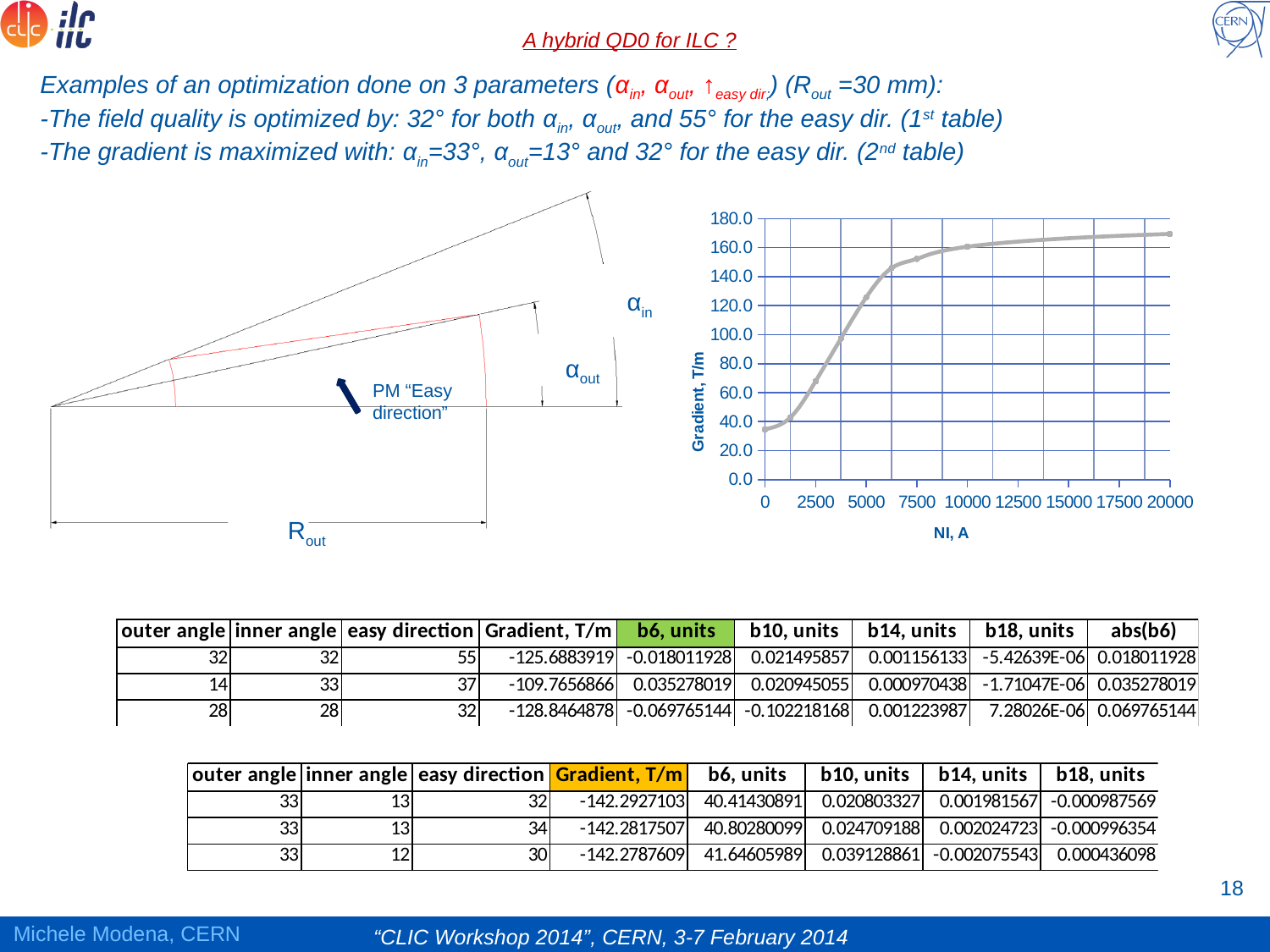
Is the gradient at NI = 0 A greater or less than 40 T/m? less What is the label of the x axis of the chart? NI, A Is the gradient at NI = 20000 A greater or less than 160 T/m? greater At which NI value is the gradient lowest? 0 Which has the larger gradient: NI = 2500 A or NI = 7500 A? 7500 What is the label of the y axis of the chart? Gradient, T/m Is the gradient at NI = 10000 A greater or less than 140 T/m? greater Does the gradient rise or fall as NI increases along the x axis? rise What is the highest value shown on the y axis of the chart? 180.0 What kind of chart is shown on the slide? line chart